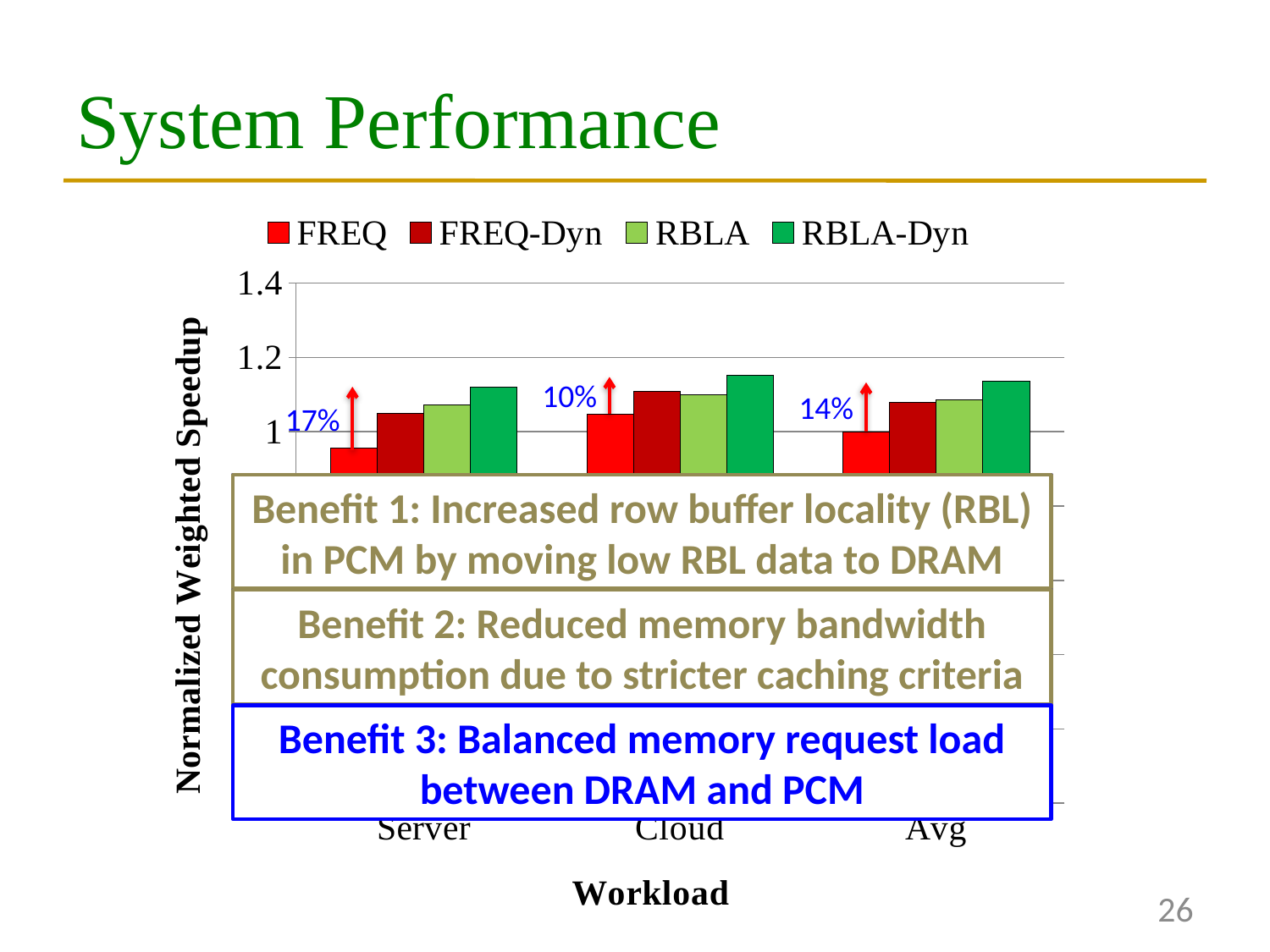
How many workload categories are shown on the x axis? 3 How many series does the legend list? 4 What kind of chart is shown on the slide? bar chart Is the RBLA-Dyn value for the Cloud workload greater or less than 1.2? less Which series has the lowest bar for the Cloud workload? FREQ Which series has the highest bar for the Server workload? RBLA-Dyn Which series has the highest bar for the Avg workload? RBLA-Dyn What is the title of the y axis? Normalized Weighted Speedup What percentage improvement is annotated above the Server workload group? 17% Is the FREQ value for the Server workload greater or less than 1? less What is the title of the x axis? Workload For the Avg workload, which is larger: the FREQ bar or the RBLA-Dyn bar? RBLA-Dyn